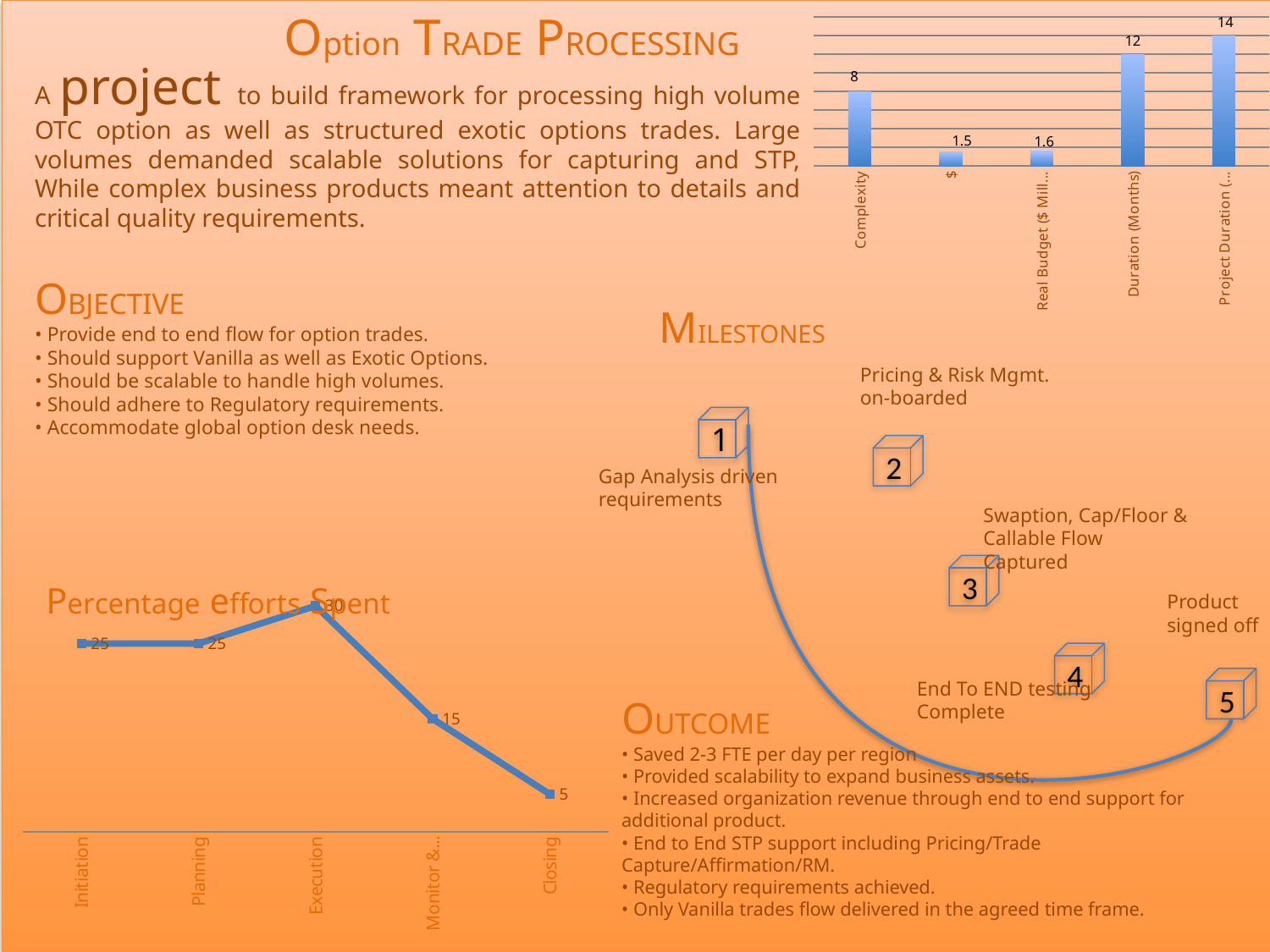
In the Percentage efforts Spent chart, what is the difference between the values for Execution and Closing? 25 In the bar chart at the top right, how many bars are plotted? 5 In the Percentage efforts Spent chart, which is larger, the value for Planning or the value for Closing? Planning In the bar chart at the top right, what is the value for Duration (Months)? 12 In the bar chart at the top right, what is the value for Complexity? 8 In the Percentage efforts Spent chart, which phase has the lowest value? Closing In the Percentage efforts Spent chart, how many phases are plotted along the x axis? 5 In the bar chart at the top right, which category has the highest value? Project Duration What kind of chart is the Percentage efforts Spent chart? Line chart What kind of chart is shown at the top right of the slide? Bar chart In the Percentage efforts Spent chart, what is the value for Execution? 30 In the bar chart at the top right, what is the difference between the values for Duration (Months) and Complexity? 4